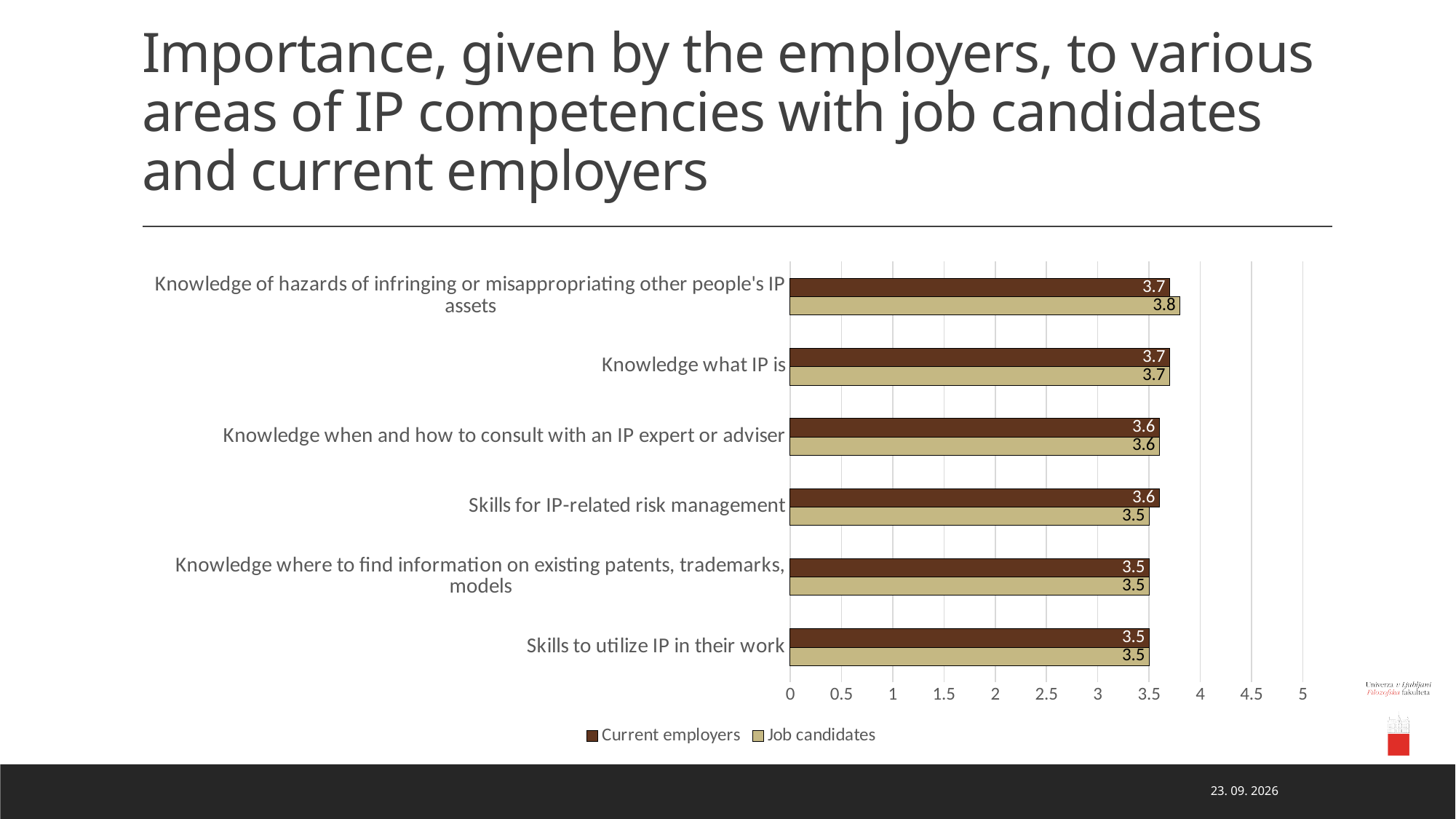
Which category has the highest value for Job candidates? Knowledge of hazards of infringing or misappropriating other people's IP assets Is the value for Current employers for 'Skills to utilize IP in their work' greater or less than 4? less What is the value for Job candidates for 'Skills to utilize IP in their work'? 3.5 How many series does the legend list? 2 What kind of chart is shown on the slide? Bar chart Which series is shown in the dark brown colour? Current employers What is the value for Job candidates for 'Knowledge of hazards of infringing or misappropriating other people's IP assets'? 3.8 For 'Skills for IP-related risk management', which is larger: the Current employers value or the Job candidates value? Current employers What is the value for Current employers for 'Knowledge what IP is'? 3.7 How many categories are shown on the chart? 6 What is the value for Current employers for 'Skills for IP-related risk management'? 3.6 What is the difference between the Job candidates and Current employers values for 'Knowledge of hazards of infringing or misappropriating other people's IP assets'? 0.1